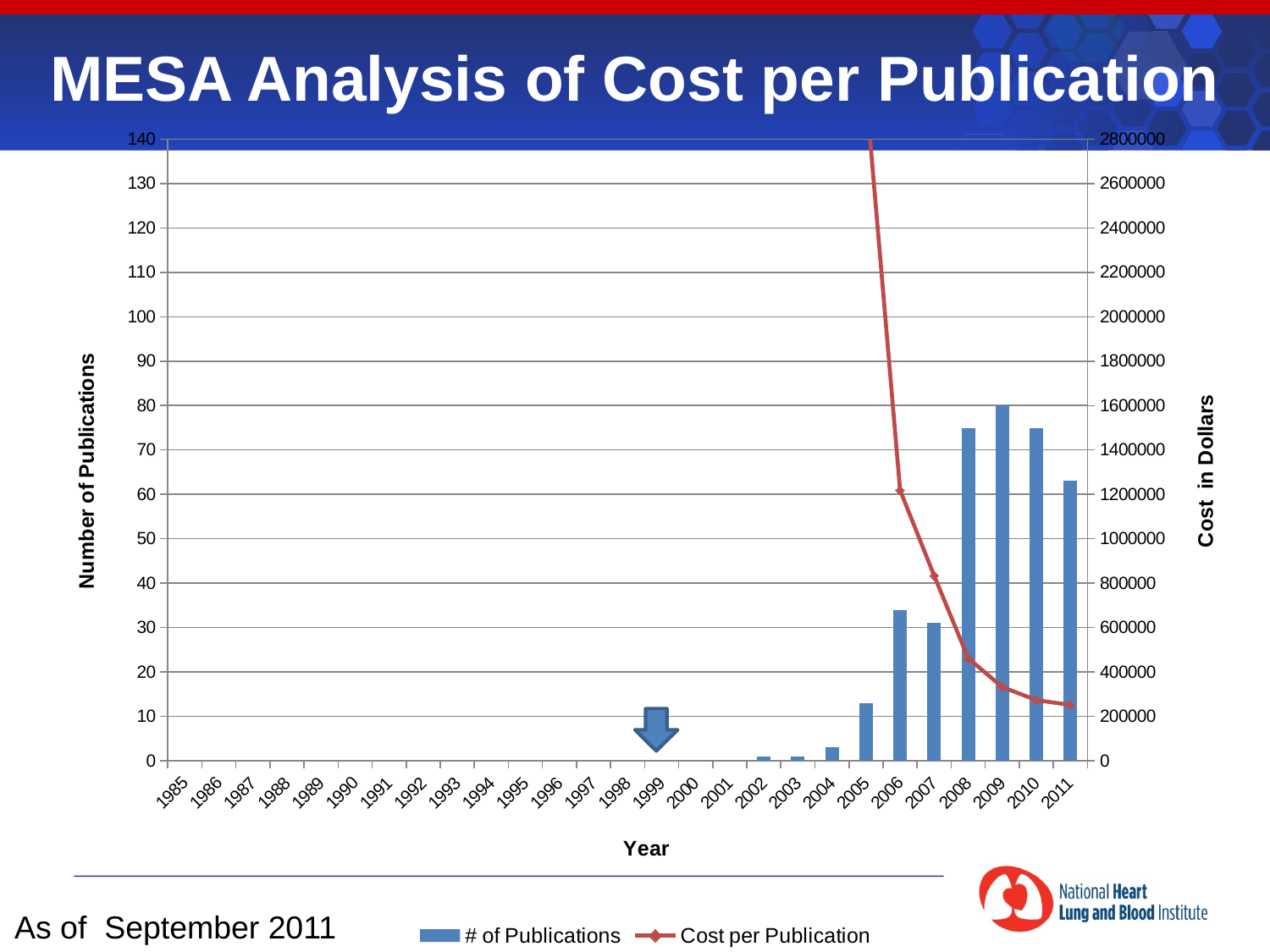
What kind of chart is this? Combined bar and line chart Is the number of publications for 2005 greater or less than 20? less Is the number of publications for 2009 greater or less than 70? greater How many series does the legend list? 2 Which year has the highest number of publications? 2009 Which year has more publications, 2008 or 2007? 2008 Is the number of publications for 2011 greater or less than 50? greater What is the title of the chart? MESA Analysis of Cost per Publication How many years are shown on the x axis? 27 Does the cost per publication rise or fall from 2006 to 2011? fall